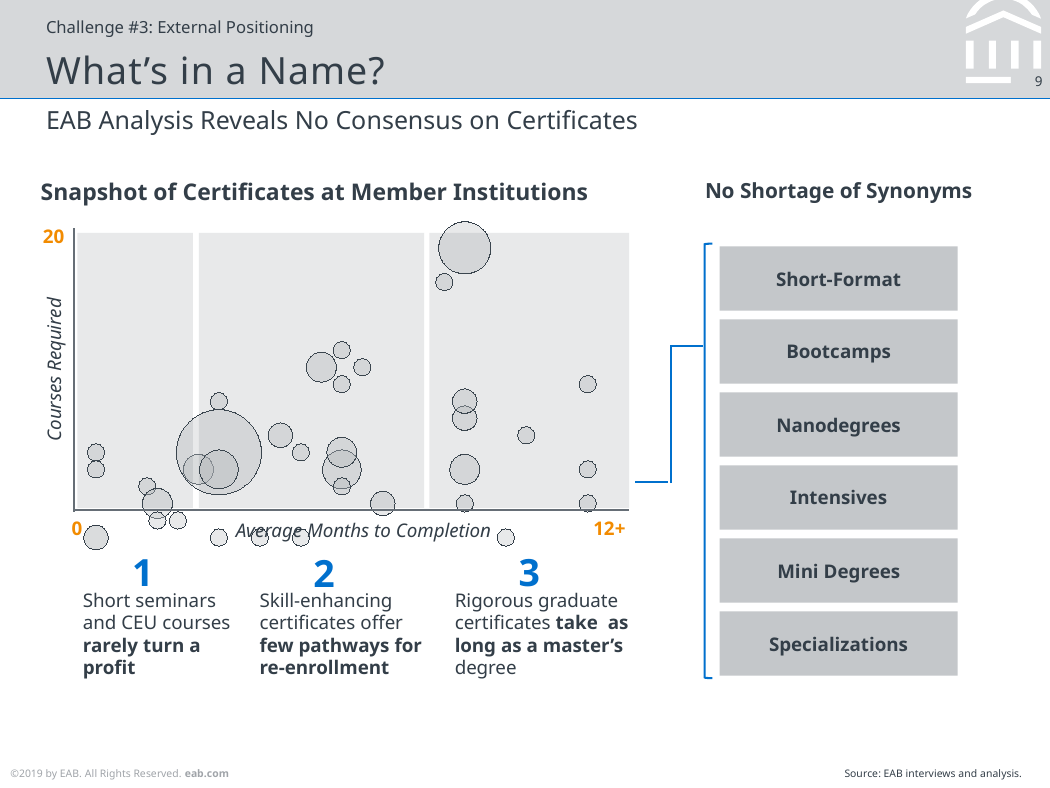
What kind of chart is 'Snapshot of Certificates at Member Institutions'? bubble chart What is the label of the vertical axis in the 'Snapshot of Certificates at Member Institutions' chart? Courses Required What is the label at the right end of the horizontal axis of the 'Snapshot of Certificates at Member Institutions' chart? 12+ Into how many numbered groups are the bubbles in the 'Snapshot of Certificates at Member Institutions' chart divided? 3 What is the highest value shown on the vertical axis of the 'Snapshot of Certificates at Member Institutions' chart? 20 What is the title of the chart on the left of the slide? Snapshot of Certificates at Member Institutions